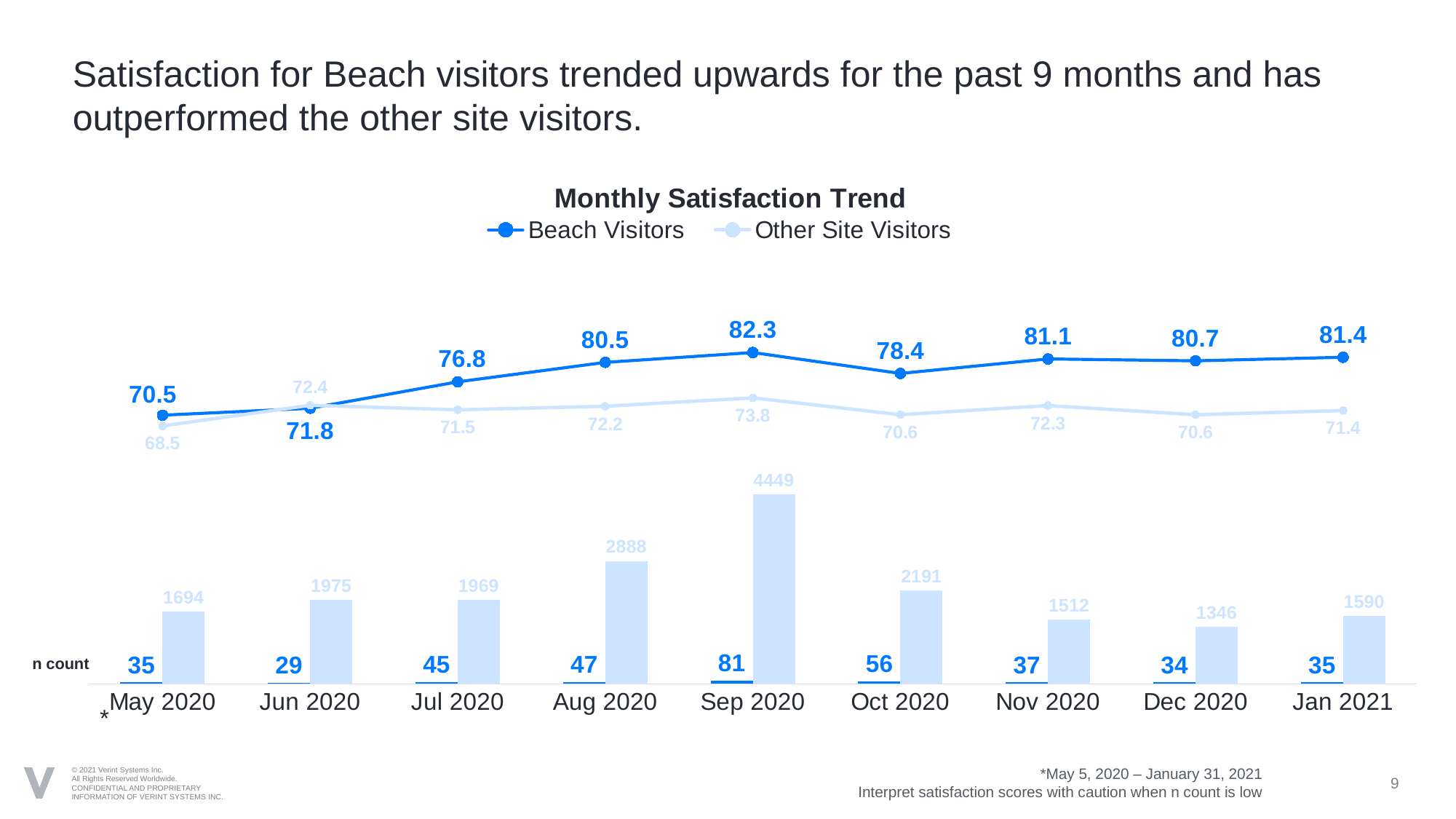
How many series does the legend list? 2 In which month is the Beach Visitors satisfaction score lowest? May 2020 Does the Beach Visitors satisfaction score rise or fall from May 2020 to Sep 2020? rise Which series has the higher satisfaction score in Jun 2020, Beach Visitors or Other Site Visitors? Other Site Visitors What is the n count for Beach Visitors in Jun 2020? 29 What is the difference between the Beach Visitors and Other Site Visitors satisfaction scores in Jan 2021? 10.0 In which month is the Beach Visitors satisfaction score highest? Sep 2020 What is the title of the chart? Monthly Satisfaction Trend How many months are shown on the x axis? 9 What is the Other Site Visitors satisfaction score for May 2020? 68.5 What is the Beach Visitors satisfaction score for Sep 2020? 82.3 What is the n count for Other Site Visitors in Sep 2020? 4449